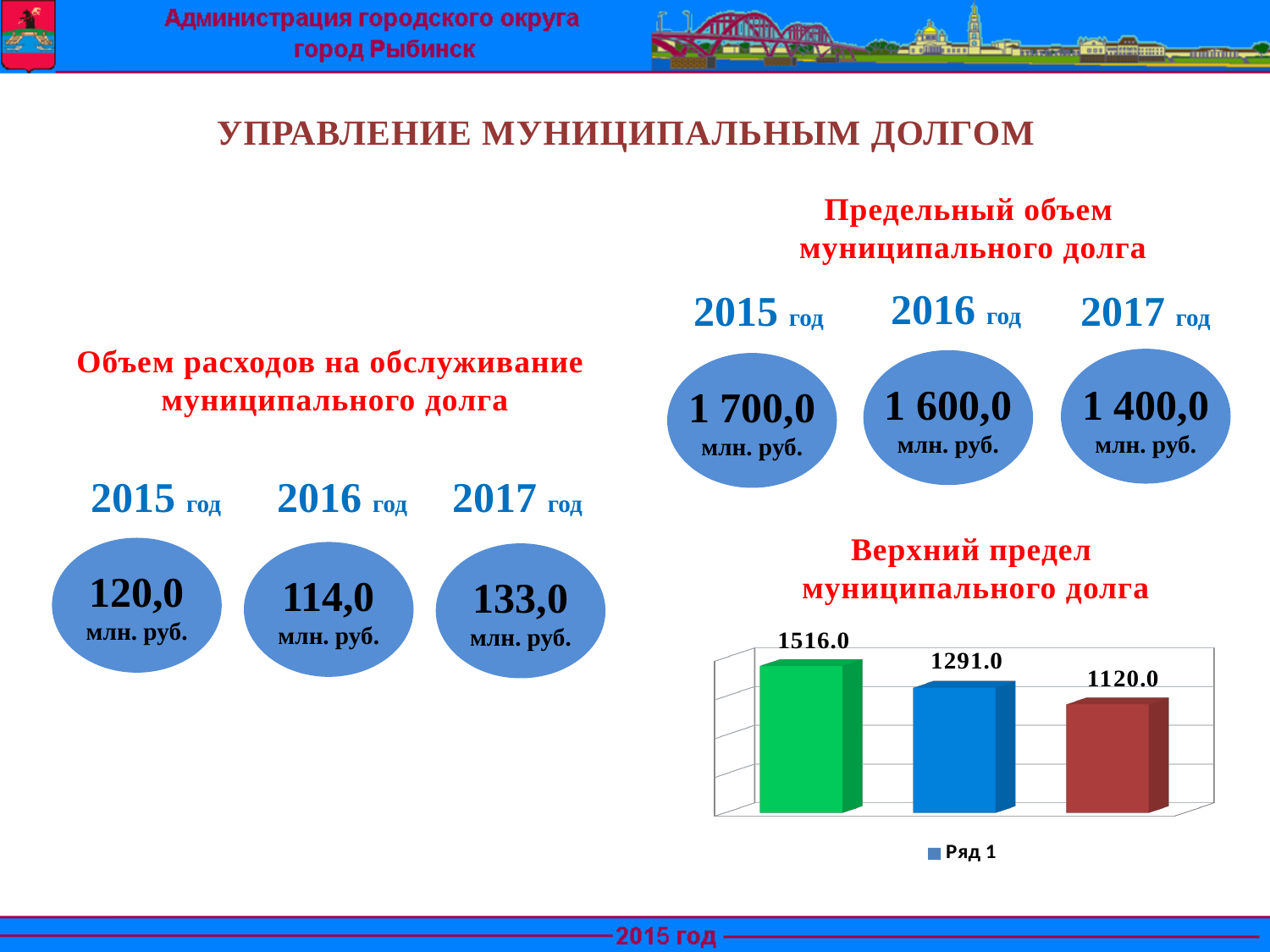
In the 'Верхний предел муниципального долга' chart, what is the value of the middle (blue) bar? 1291.0 In the 'Верхний предел муниципального долга' chart, is the middle (blue) bar larger or smaller than the rightmost (red) bar? larger How many bars are plotted in the 'Верхний предел муниципального долга' chart? 3 How many series does the legend of the 'Верхний предел муниципального долга' chart list? 1 In the 'Верхний предел муниципального долга' chart, what is the difference between the first bar and the last bar? 396.0 In the 'Верхний предел муниципального долга' chart, what is the value of the first (green) bar? 1516.0 In the 'Верхний предел муниципального долга' chart, which bar has the highest value? the first (green) bar, 1516.0 What type of chart is shown under the title 'Верхний предел муниципального долга'? bar chart In the 'Верхний предел муниципального долга' chart, which bar has the lowest value? the rightmost (red) bar, 1120.0 Do the values in the 'Верхний предел муниципального долга' chart rise or fall from left to right? fall In the 'Верхний предел муниципального долга' chart, what is the value of the rightmost (red) bar? 1120.0 In the 'Верхний предел муниципального долга' chart, what is the difference between the first bar (1516.0) and the middle bar (1291.0)? 225.0